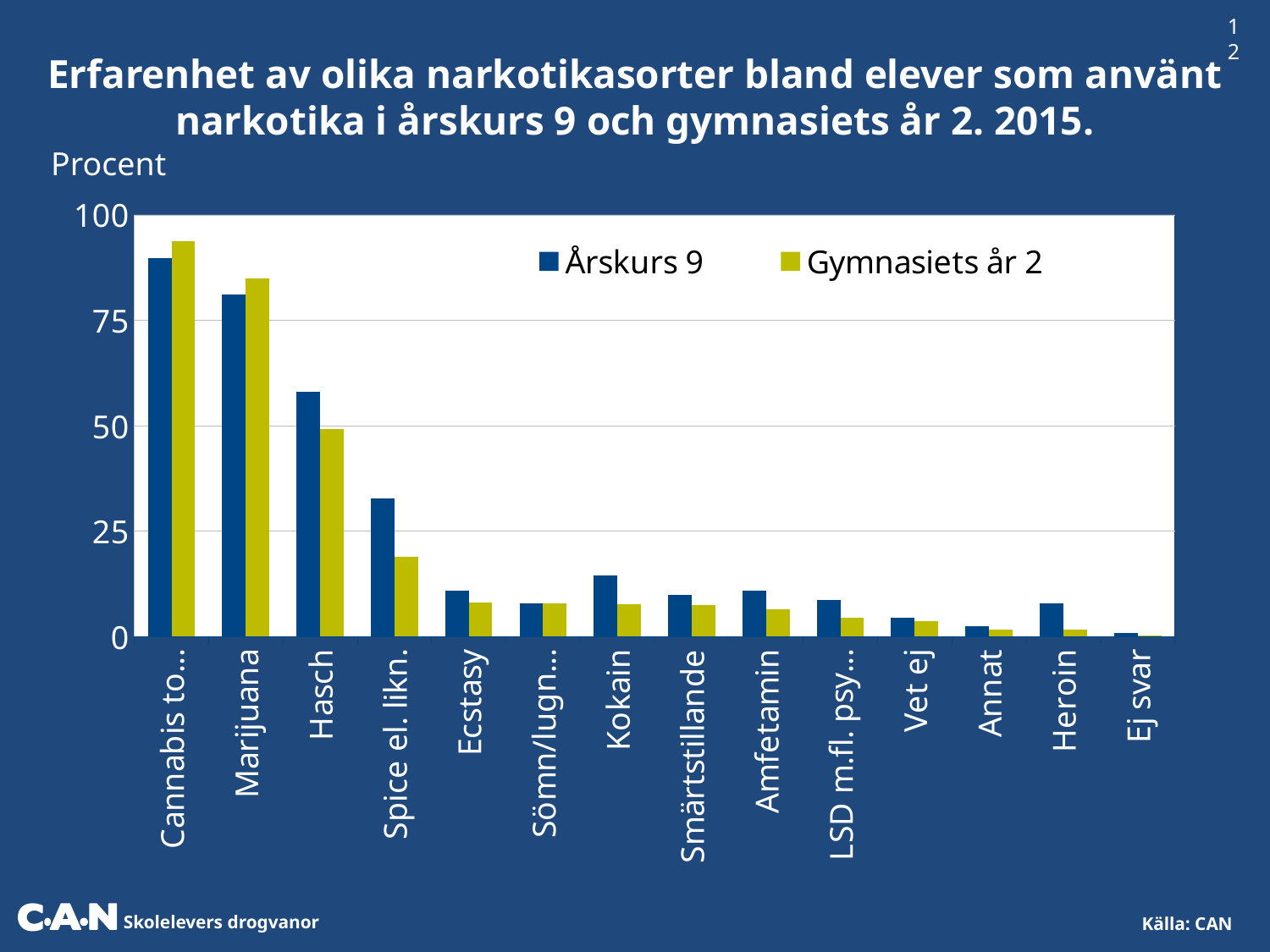
Is the value for Hasch in the Årskurs 9 series greater or less than 50? greater Is the value for Marijuana in the Årskurs 9 series greater or less than 75? greater How many categories are shown on the x axis? 14 What kind of chart is shown on the slide? bar chart Which category has the highest value for Årskurs 9? Cannabis to... Which category has the lowest value for Gymnasiets år 2? Ej svar Is the value for Spice el. likn. in the Gymnasiets år 2 series greater or less than 25? less For Hasch, which series has the larger value, Årskurs 9 or Gymnasiets år 2? Årskurs 9 How many series does the legend list? 2 For Cannabis to..., which series has the larger value, Årskurs 9 or Gymnasiets år 2? Gymnasiets år 2 Do the values generally rise or fall from left to right along the x axis? fall